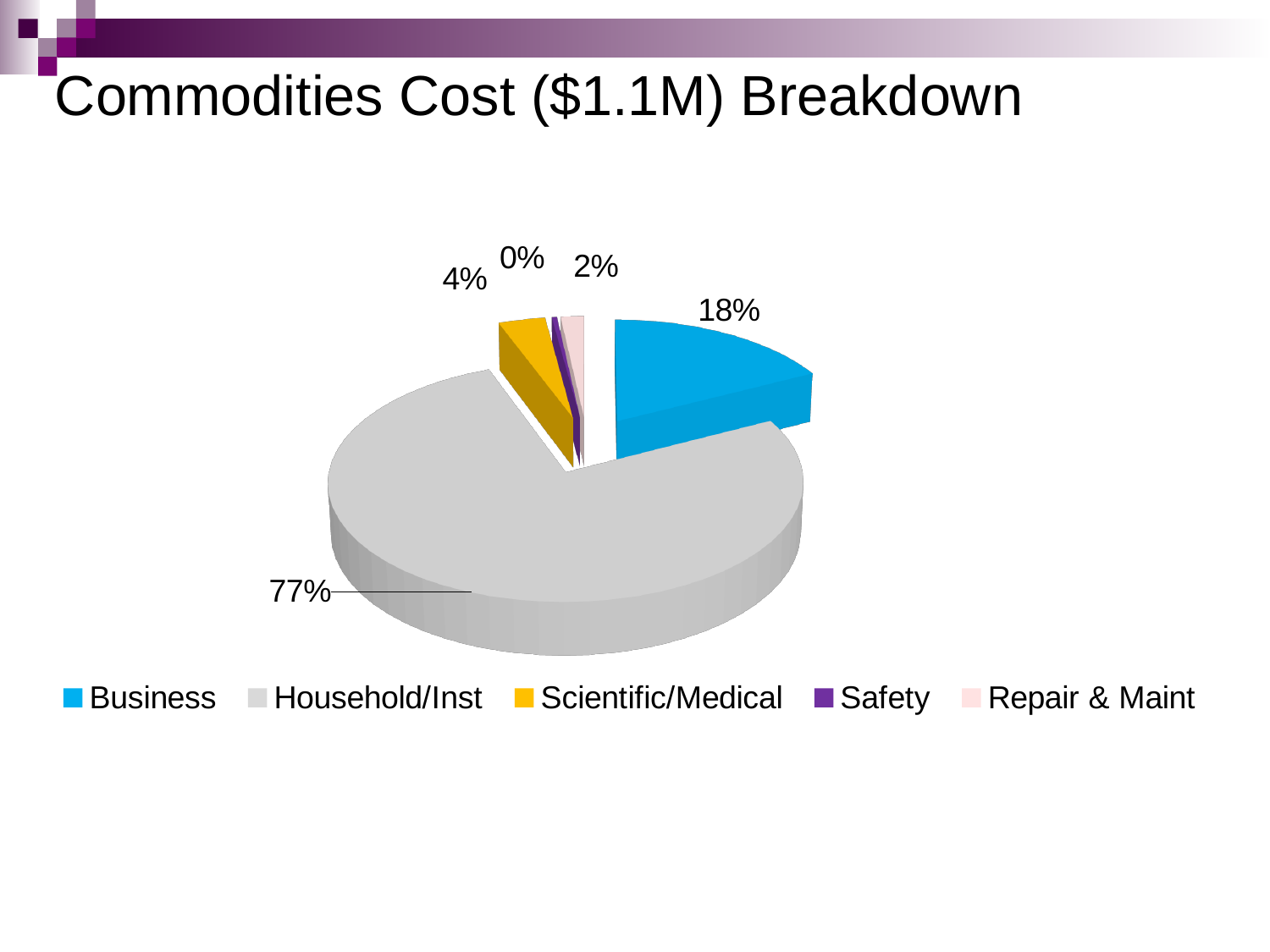
Which category has the smallest share of the pie? Safety What share of the pie does Household/Inst represent? 77% What share of the pie does Business represent? 18% What kind of chart is shown on the slide? Pie chart Which has a larger share, Scientific/Medical or Repair & Maint? Scientific/Medical How many categories does the legend list? 5 Which category has the largest share of the pie? Household/Inst What share of the pie does Safety represent? 0% What is the difference in percentage points between the Household/Inst and Business shares? 59 What is the title of the slide? Commodities Cost ($1.1M) Breakdown